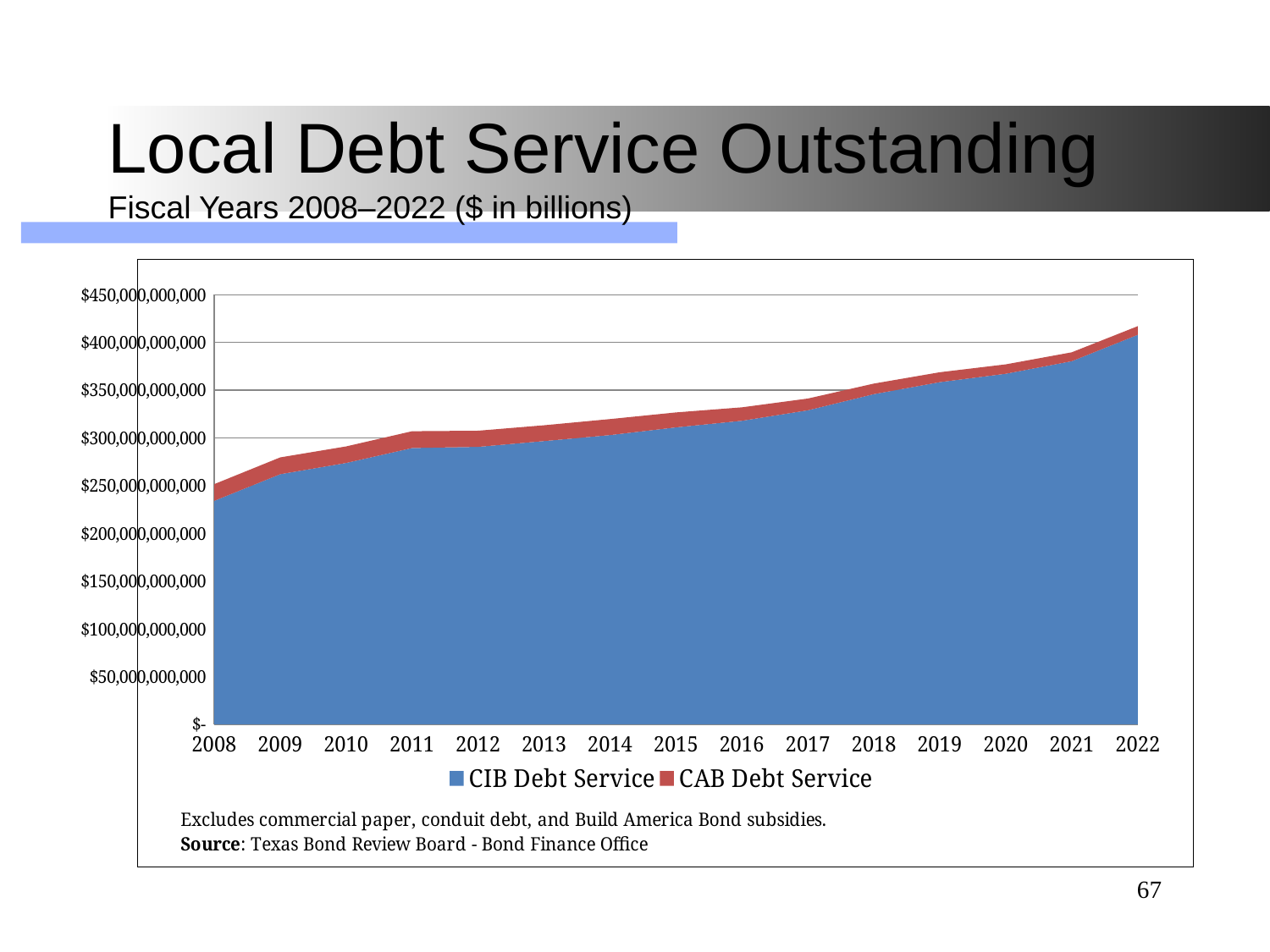
What are the two series named in the legend? CIB Debt Service and CAB Debt Service Which colour represents CAB Debt Service in the chart? Red In 2022, which is larger: CIB Debt Service or CAB Debt Service? CIB Debt Service Is the total debt service outstanding in 2015 greater or less than $300,000,000,000? greater Does total local debt service outstanding generally rise or fall from 2008 to 2022? Rise Is the total debt service outstanding in 2022 greater or less than $400,000,000,000? greater What kind of chart is shown on the slide? Stacked area chart In which fiscal year is total debt service outstanding highest? 2022 How many fiscal years are shown along the x axis? 15 Is the total debt service outstanding in 2020 greater or less than $400,000,000,000? less In which fiscal year is total debt service outstanding lowest? 2008 How many series does the legend list? 2